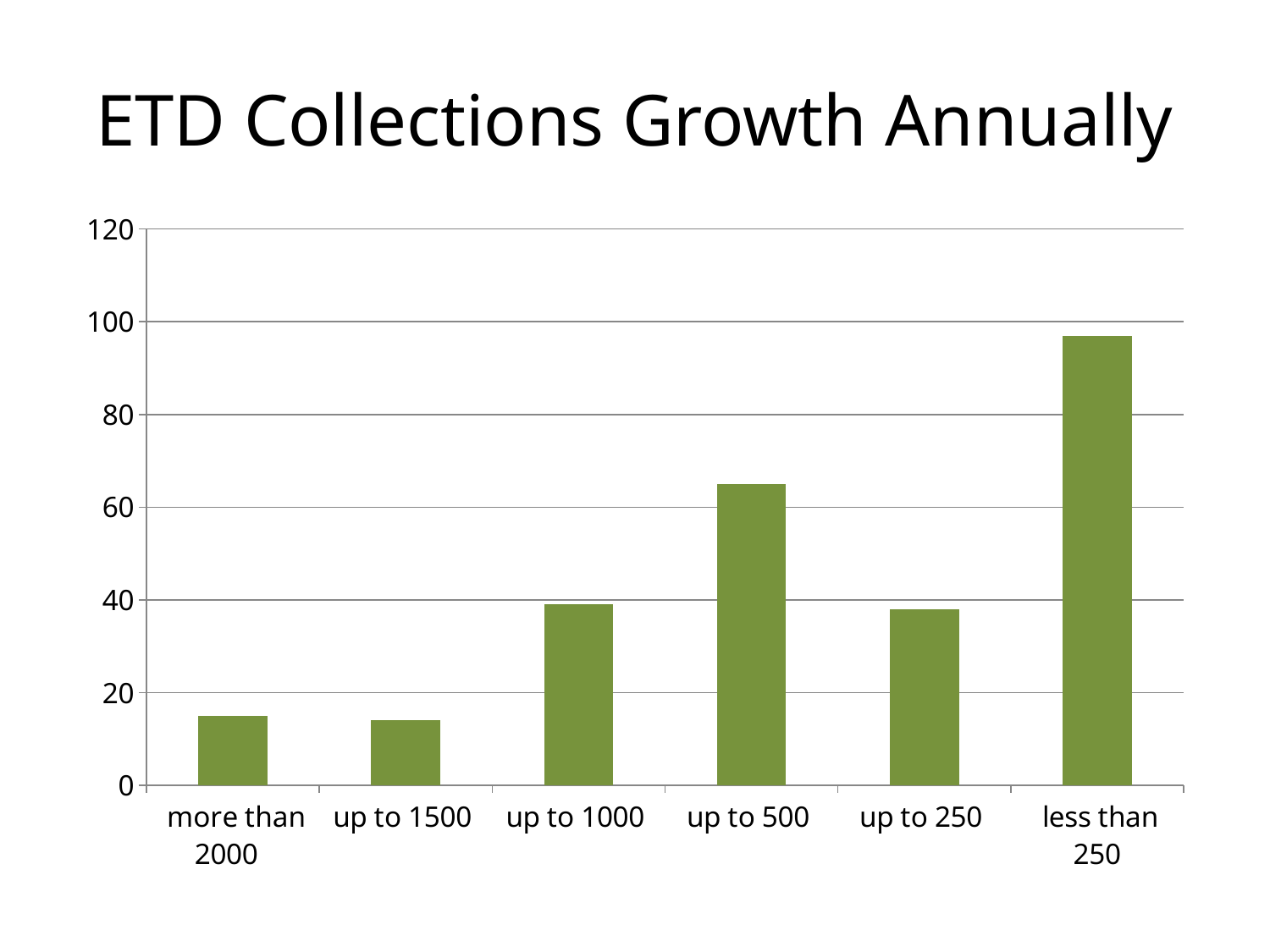
Is the value for "up to 500" greater or less than 60? greater What kind of chart is shown on the slide? bar chart Which is larger, the value for "up to 500" or the value for "up to 1000"? up to 500 Is the value for "up to 1000" greater or less than 20? greater How many categories are shown on the x axis? 6 Is the value for "less than 250" greater or less than 80? greater Which category has the highest value? less than 250 What is the title of the chart? ETD Collections Growth Annually Which is larger, the value for "less than 250" or the value for "up to 500"? less than 250